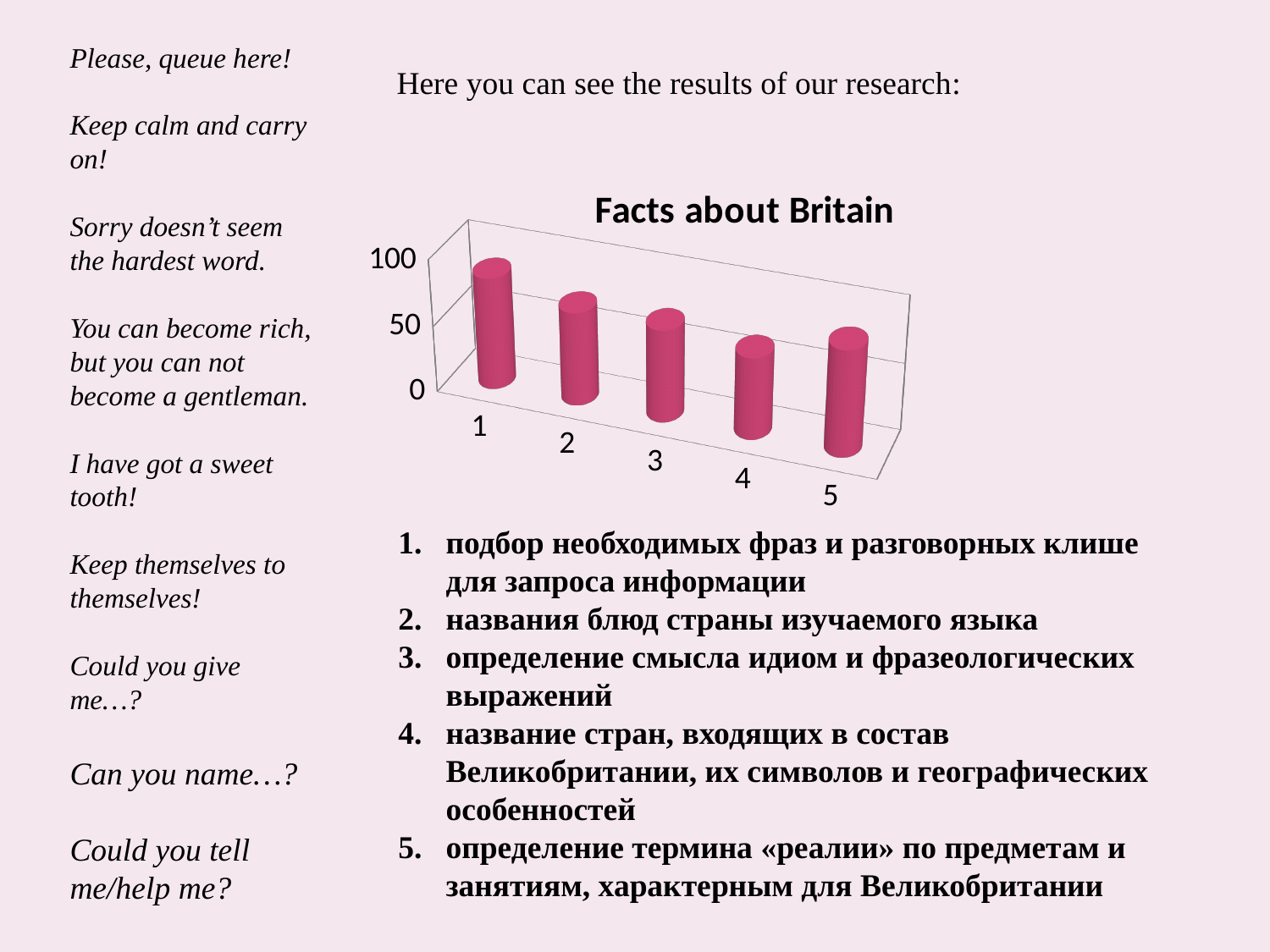
What kind of chart is shown under the title "Facts about Britain"? bar chart What is the title of the chart? Facts about Britain Which is larger, the value for category 1 or category 2? category 1 Do the values generally rise or fall from category 1 to category 4? fall What is the highest value labelled on the vertical axis? 100 How many categories are plotted on the chart? 5 Which category has the highest bar? 1 Is the value for category 1 greater or less than 50? greater Which is larger, the value for category 2 or category 4? category 2 Which is larger, the value for category 1 or category 4? category 1